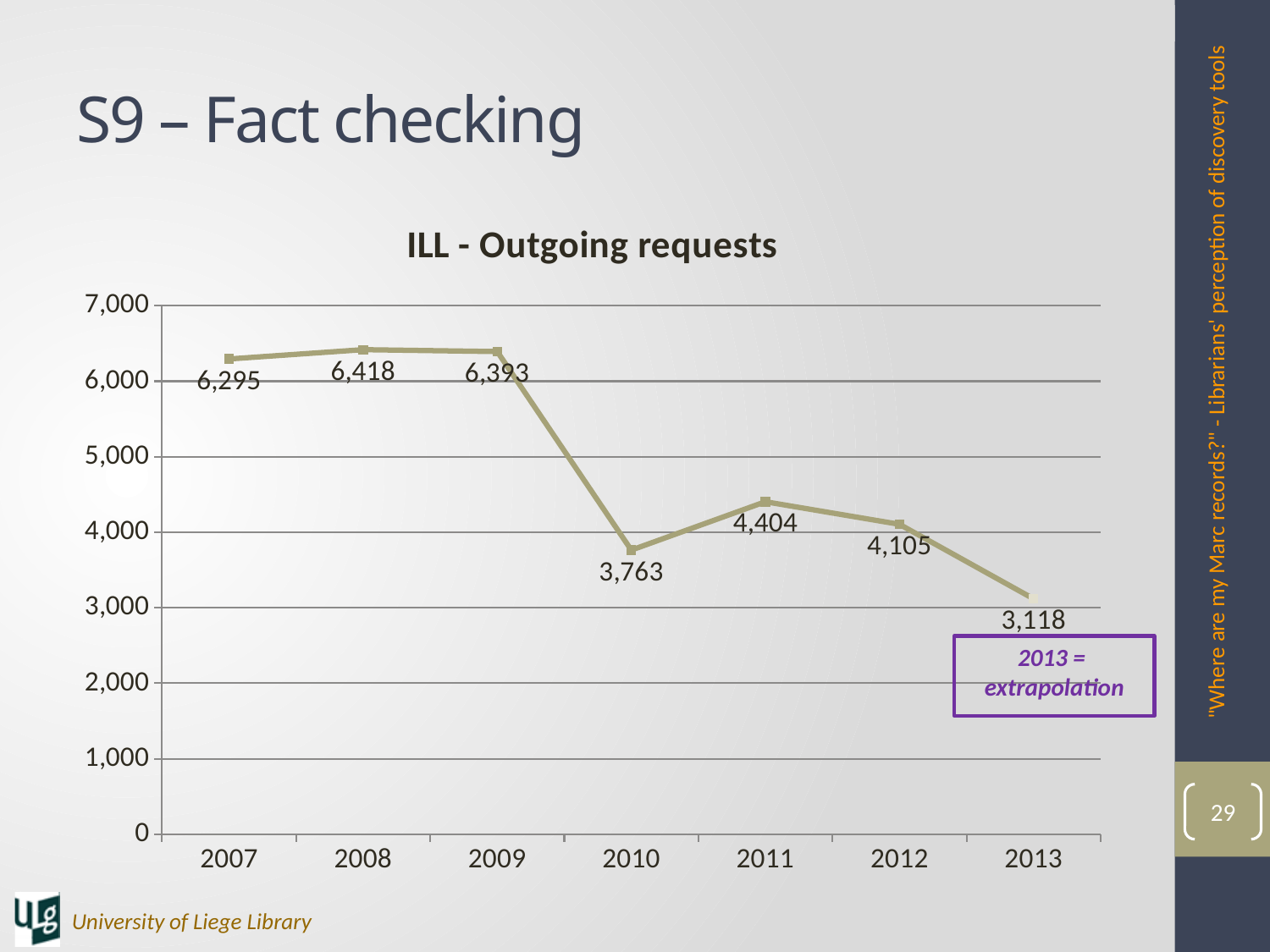
How many years are plotted in the ILL - Outgoing requests chart? 7 What kind of chart is the ILL - Outgoing requests chart? line chart Which year has the lowest value in the ILL - Outgoing requests chart? 2013 According to the note on the chart, which year's value is an extrapolation? 2013 What is the value for 2007 in the ILL - Outgoing requests chart? 6,295 Is the value for 2011 in the ILL - Outgoing requests chart greater or less than 4,000? greater What is the difference between the values for 2009 and 2010 in the ILL - Outgoing requests chart? 2,630 What is the value for 2010 in the ILL - Outgoing requests chart? 3,763 Which year has the highest value in the ILL - Outgoing requests chart? 2008 Do the values in the ILL - Outgoing requests chart generally rise or fall from 2009 to 2013? fall Which is larger in the ILL - Outgoing requests chart, the value for 2011 or the value for 2012? 2011 What is the value for 2013 in the ILL - Outgoing requests chart? 3,118